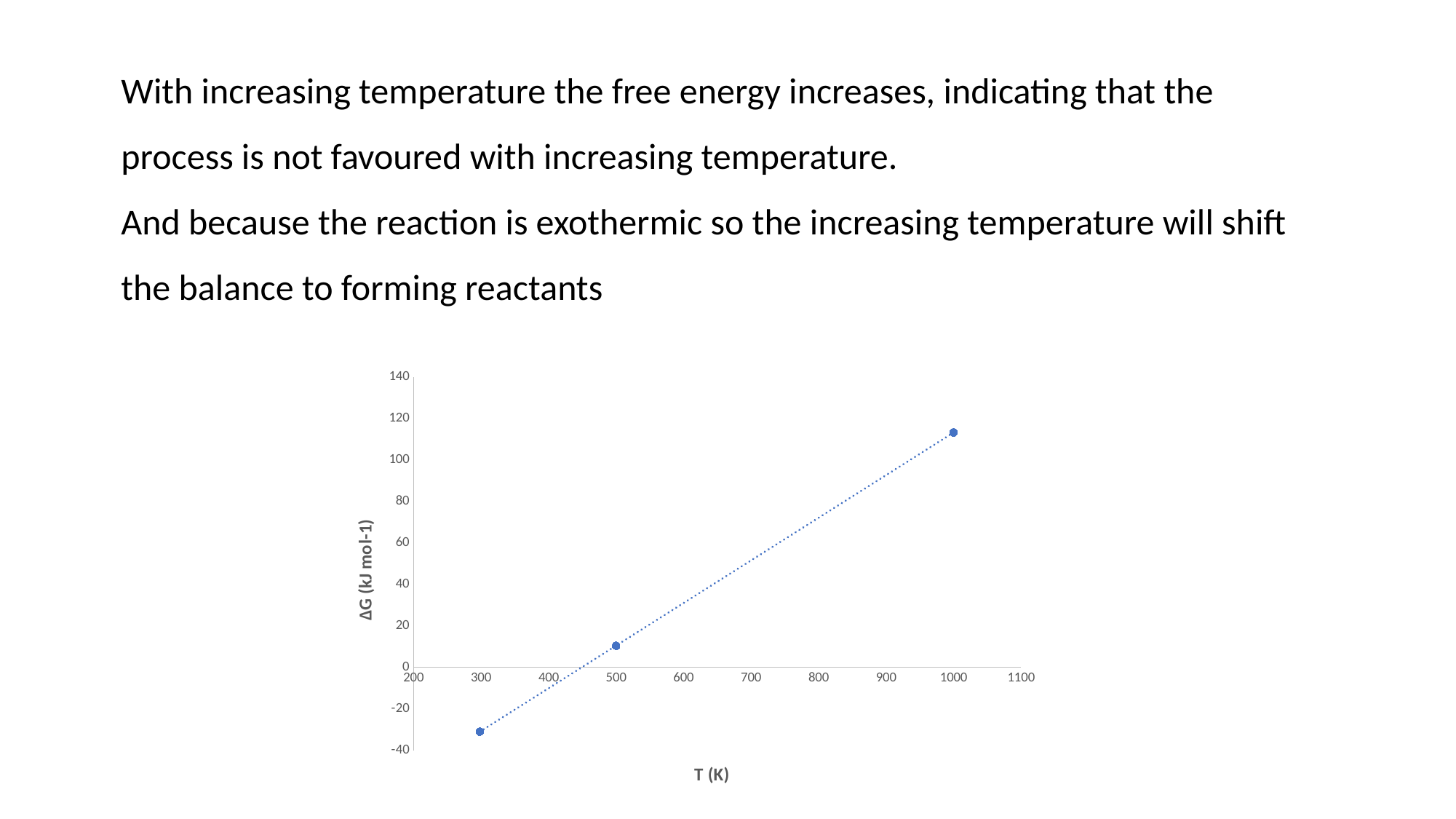
How many data points are plotted on the chart? 3 Do the plotted ΔG values rise or fall as T increases along the x axis? rise What is the title of the vertical axis? ΔG (kJ mol-1) At which temperature is the plotted ΔG value highest? 1000 Is the ΔG value for the point at T = 1000 K greater or less than 120? less Is the ΔG value for the point at T = 1000 K greater or less than 100? greater Is the ΔG value for the point at T = 300 K greater or less than 0? less What kind of chart is shown on the slide? scatter chart Which point has the larger ΔG value, the one at T = 500 K or the one at T = 1000 K? T = 1000 K What is the title of the horizontal axis? T (K)